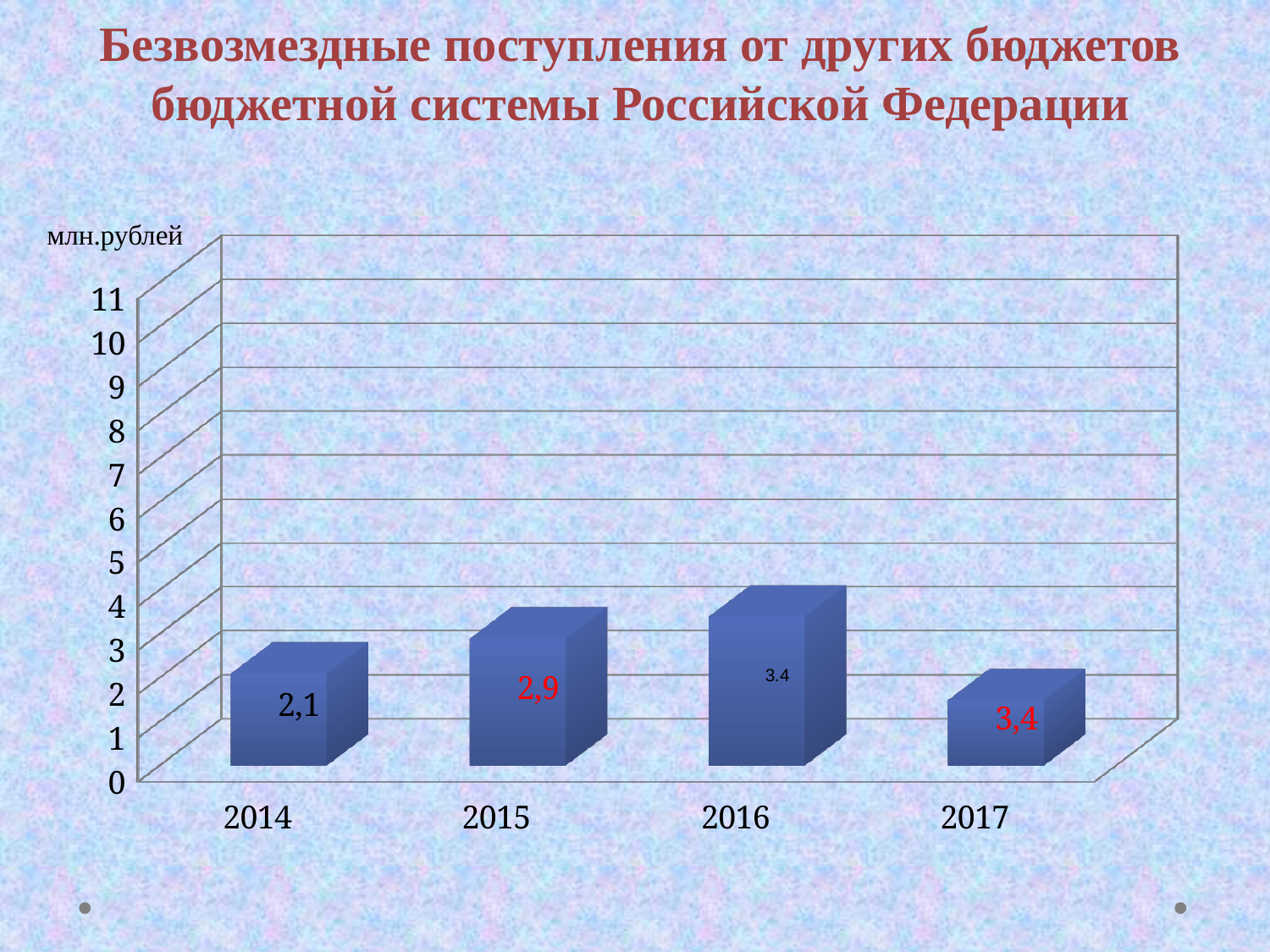
What is the value for 2016? 3.4 Is the value for 2015 greater or less than 2? greater Which is larger, the value for 2015 or the value for 2014? 2015 Is the value for 2014 greater or less than 3? less What is the value for 2015? 2,9 What kind of chart is shown on the slide? bar chart How many years are shown on the x axis? 4 Do the values rise or fall from 2014 to 2016? rise What unit is written above the vertical axis? млн.рублей What is the difference between the values for 2015 and 2014? 0,8 What is the value for 2014? 2,1